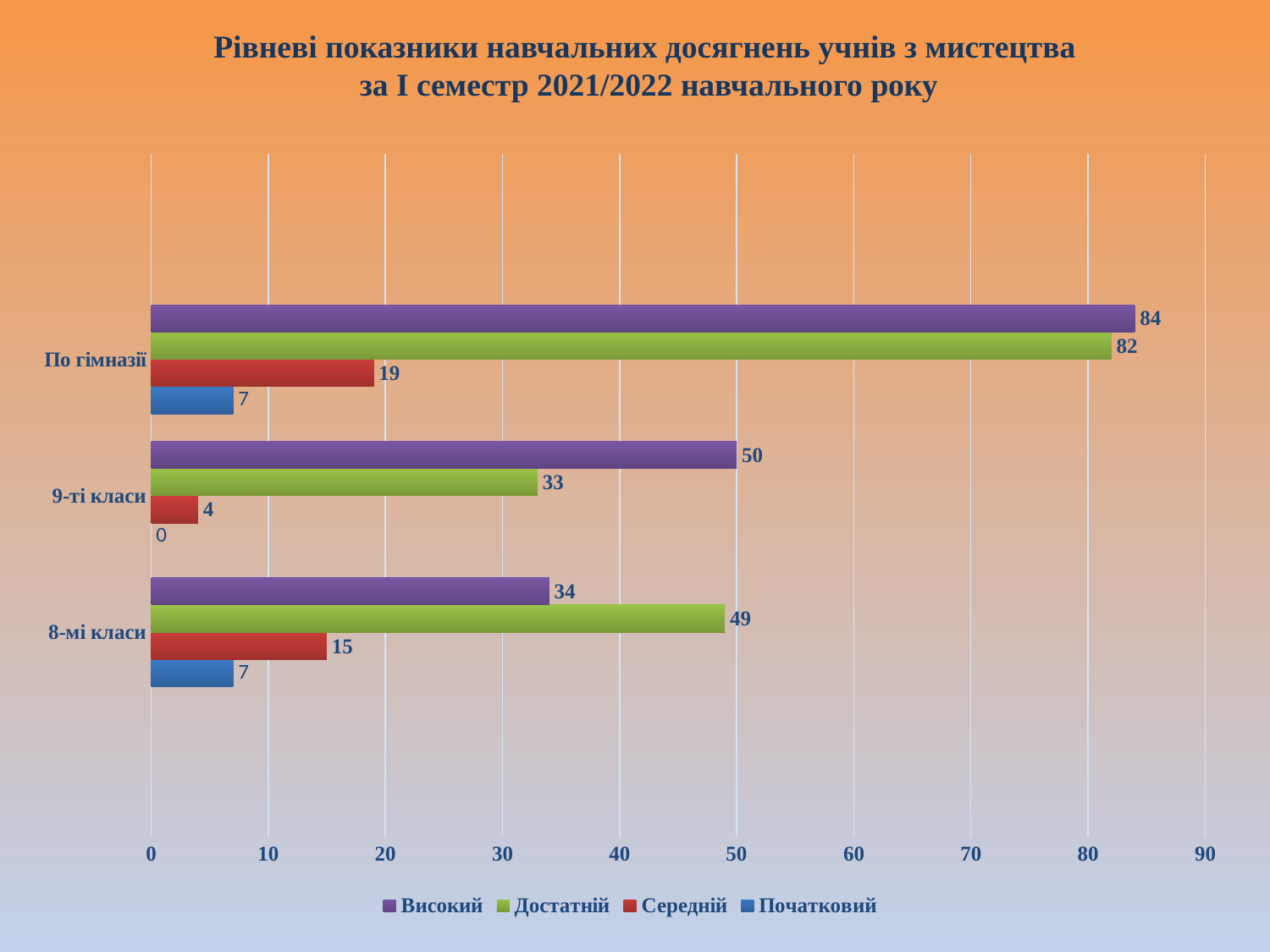
What is the difference between Високий and Достатній for 9-ті класи? 17 What is the value for Початковий for 9-ті класи? 0 How many series does the legend list? 4 What kind of chart is shown on the slide? Bar chart What is the value for Достатній for 8-мі класи? 49 Which category has the lowest value for Високий? 8-мі класи Which category has the highest value for Достатній? По гімназії Which series is shown in green in the legend? Достатній What is the value for Середній for 9-ті класи? 4 What is the value for Високий for По гімназії? 84 How many categories are shown on the y axis? 3 Which is larger for 8-мі класи: Високий or Достатній? Достатній